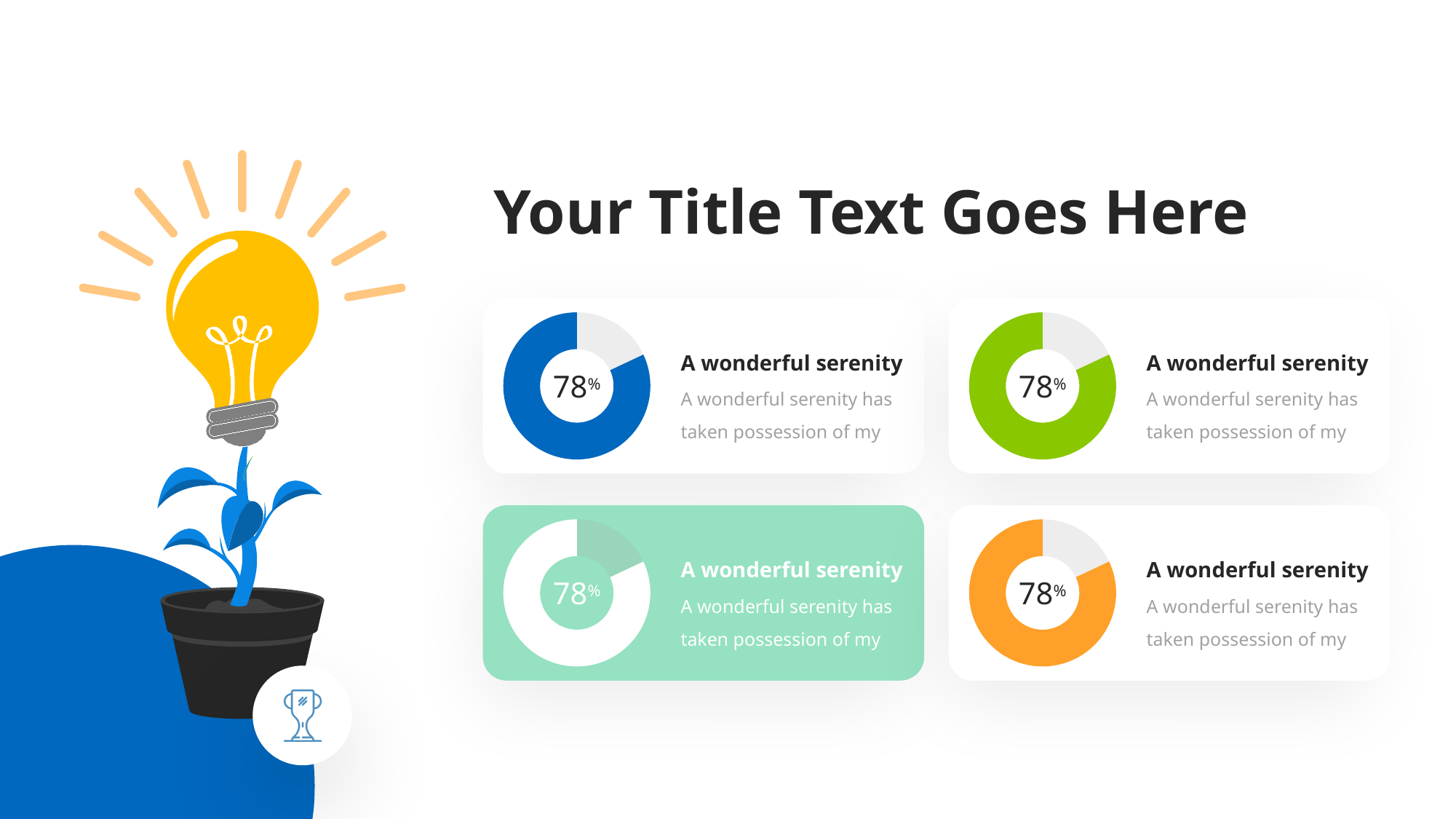
How many donut charts are on the slide? 4 What value is shown in the centre of the white donut chart on the teal card at the bottom left? 78% What value is shown in the centre of the blue donut chart at the top left of the card group? 78% Is the value in the blue donut chart larger or smaller than the value in the orange donut chart? Equal What heading text appears next to each donut chart? A wonderful serenity What colour is the filled segment of the donut chart in the bottom-right card? Orange Is the value shown in the orange donut chart greater or less than 50%? greater What value is shown in the centre of the green donut chart at the top right? 78% What value is shown in the centre of the orange donut chart at the bottom right? 78% What kind of chart is used in each of the four cards? Donut chart How many segments does each donut chart have? 2